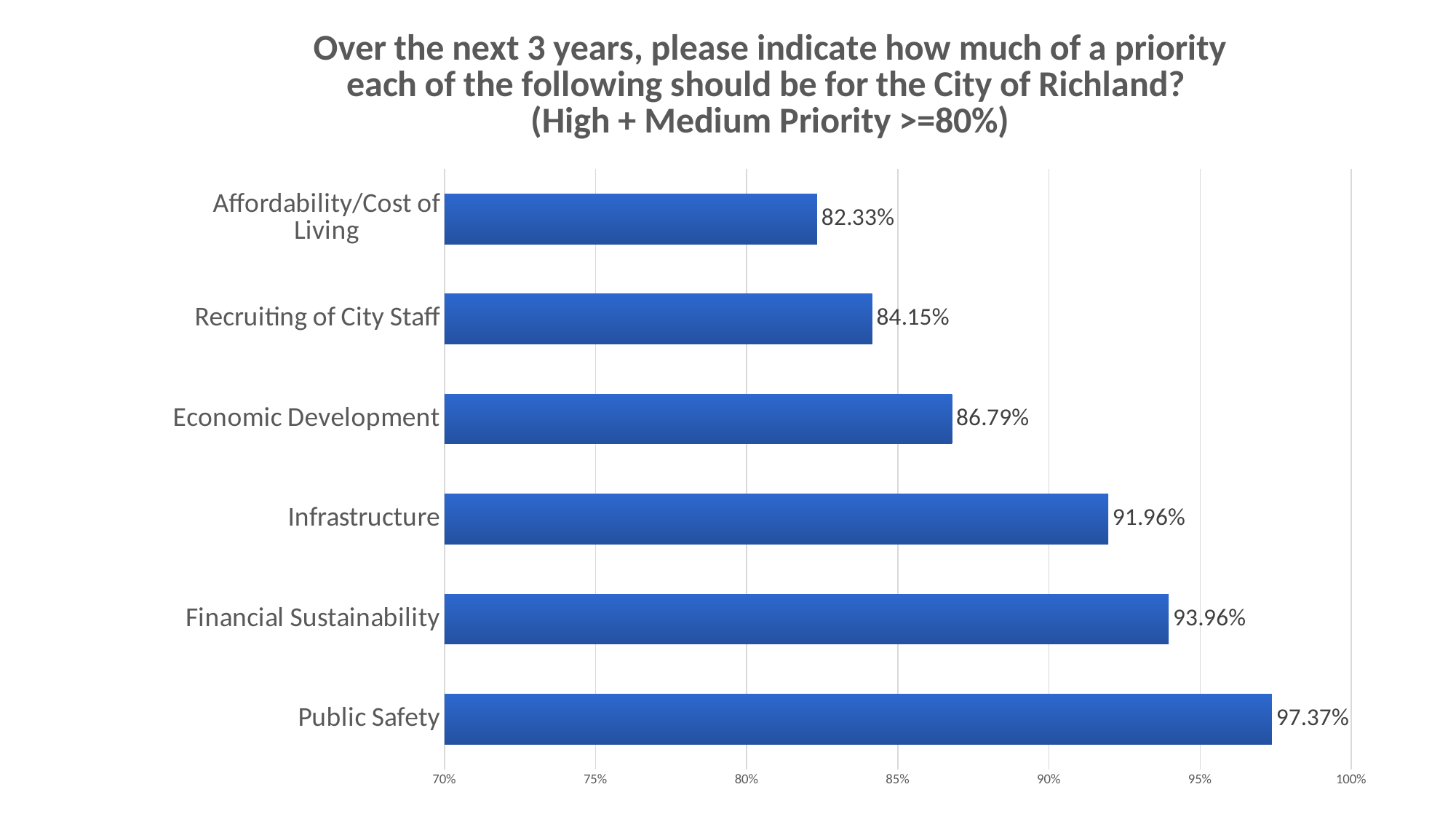
Is the value for Recruiting of City Staff greater or less than 85%? less What is the value for Economic Development? 86.79% Which is larger, the value for Infrastructure or the value for Economic Development? Infrastructure What is the value for Affordability/Cost of Living? 82.33% What is the difference between the values for Infrastructure and Recruiting of City Staff? 7.81% Which category has the lowest value? Affordability/Cost of Living How many categories are shown in the chart? 6 What kind of chart is shown on the slide? Bar chart What is the lowest value shown on the horizontal axis? 70% What is the difference between the values for Public Safety and Financial Sustainability? 3.41% What is the value for Public Safety? 97.37% Which category has the highest value? Public Safety